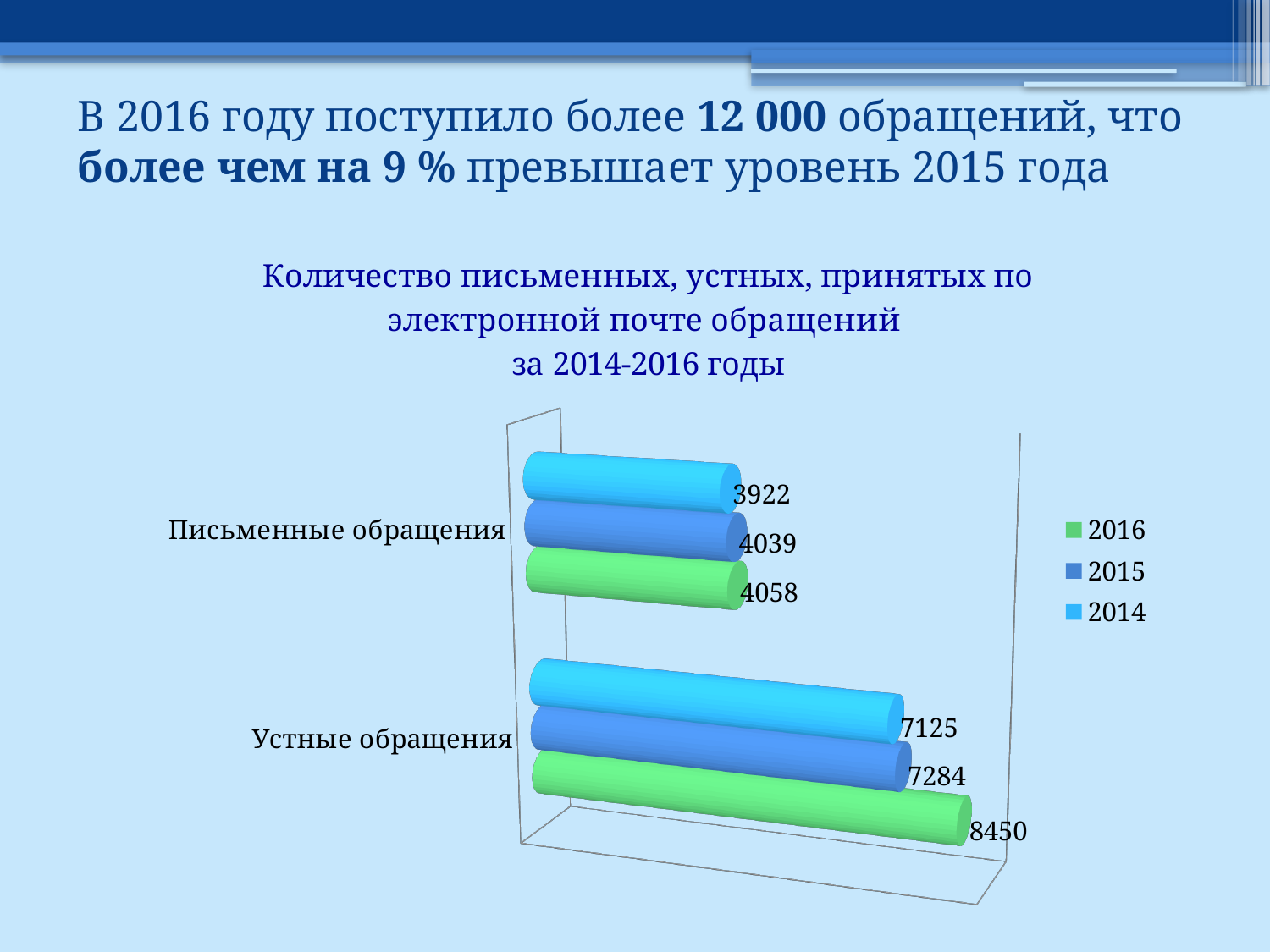
Which year has the highest value for Устные обращения? 2016 Which is larger: Устные обращения in 2016 or Письменные обращения in 2016? Устные обращения in 2016 What is the difference between Устные обращения in 2016 and in 2015? 1166 What is the value for Письменные обращения in 2016? 4058 How many categories are shown on the chart? 2 What is the value for Устные обращения in 2014? 7125 Which year has the lowest value for Письменные обращения? 2014 What is the value for Устные обращения in 2015? 7284 What is the value for Письменные обращения in 2014? 3922 How many series does the legend list? 3 What is the difference between Письменные обращения in 2015 and in 2014? 117 What kind of chart is shown on the slide? Bar chart